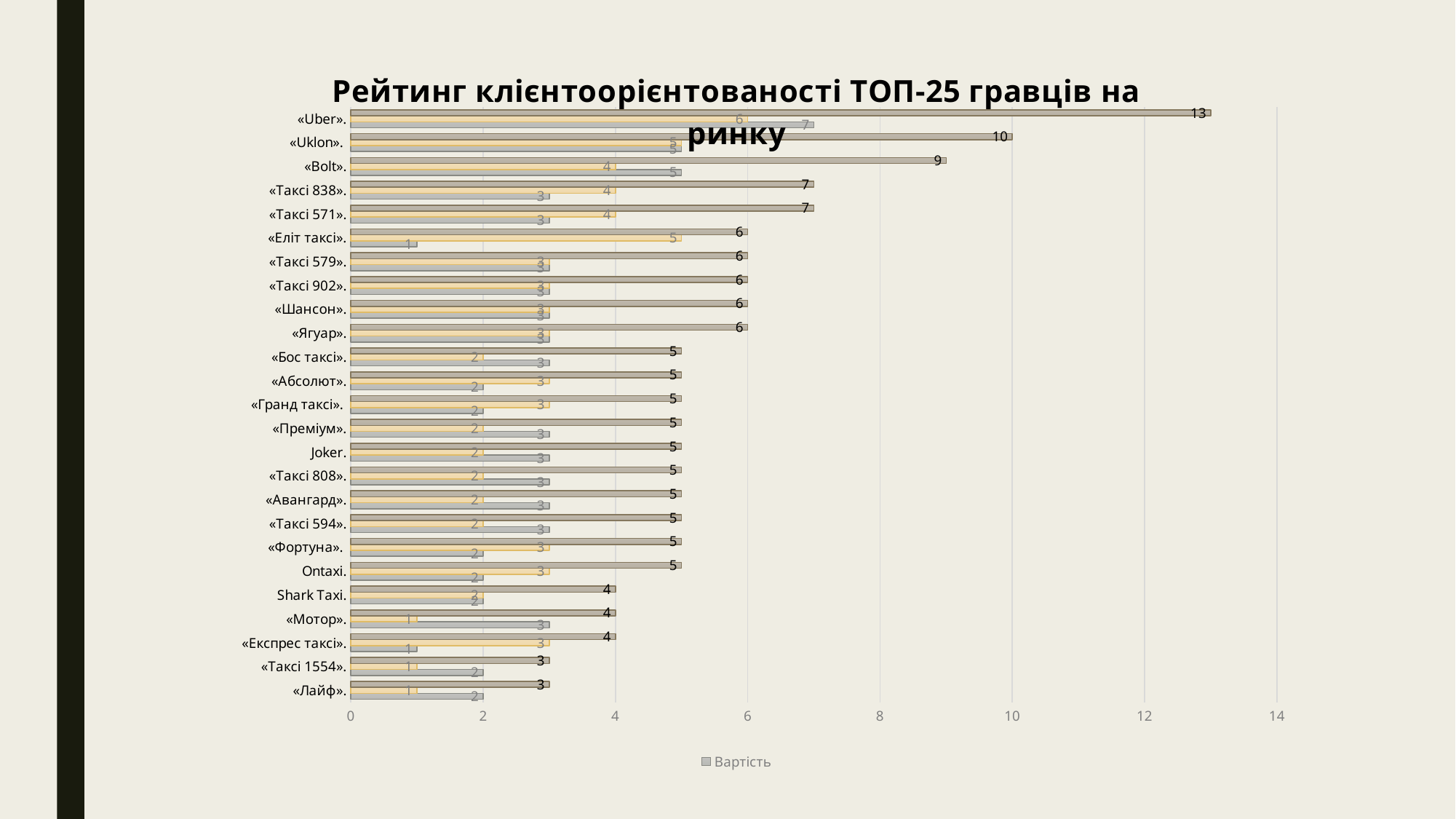
What is the title of the chart? Рейтинг клієнтоорієнтованості ТОП-25 гравців на ринку What value is labelled on the longest bar for «Bolt»? 9 Which company has the highest labelled value in the chart? «Uber» How many series does the chart legend list? 1 Is the longest-bar value for «Лайф» greater or less than 4? less What is the difference between the longest-bar values of «Uber» (13) and «Uklon» (10)? 3 What value is labelled on the longest bar for «Uber»? 13 Which has the larger longest-bar value, «Bolt» or «Таксі 838»? «Bolt» What value is labelled on the longest bar for «Uklon»? 10 What kind of chart is shown on the slide? bar chart How many categories (companies) are listed on the vertical axis of the chart? 25 What is the legend entry shown below the chart? Вартість